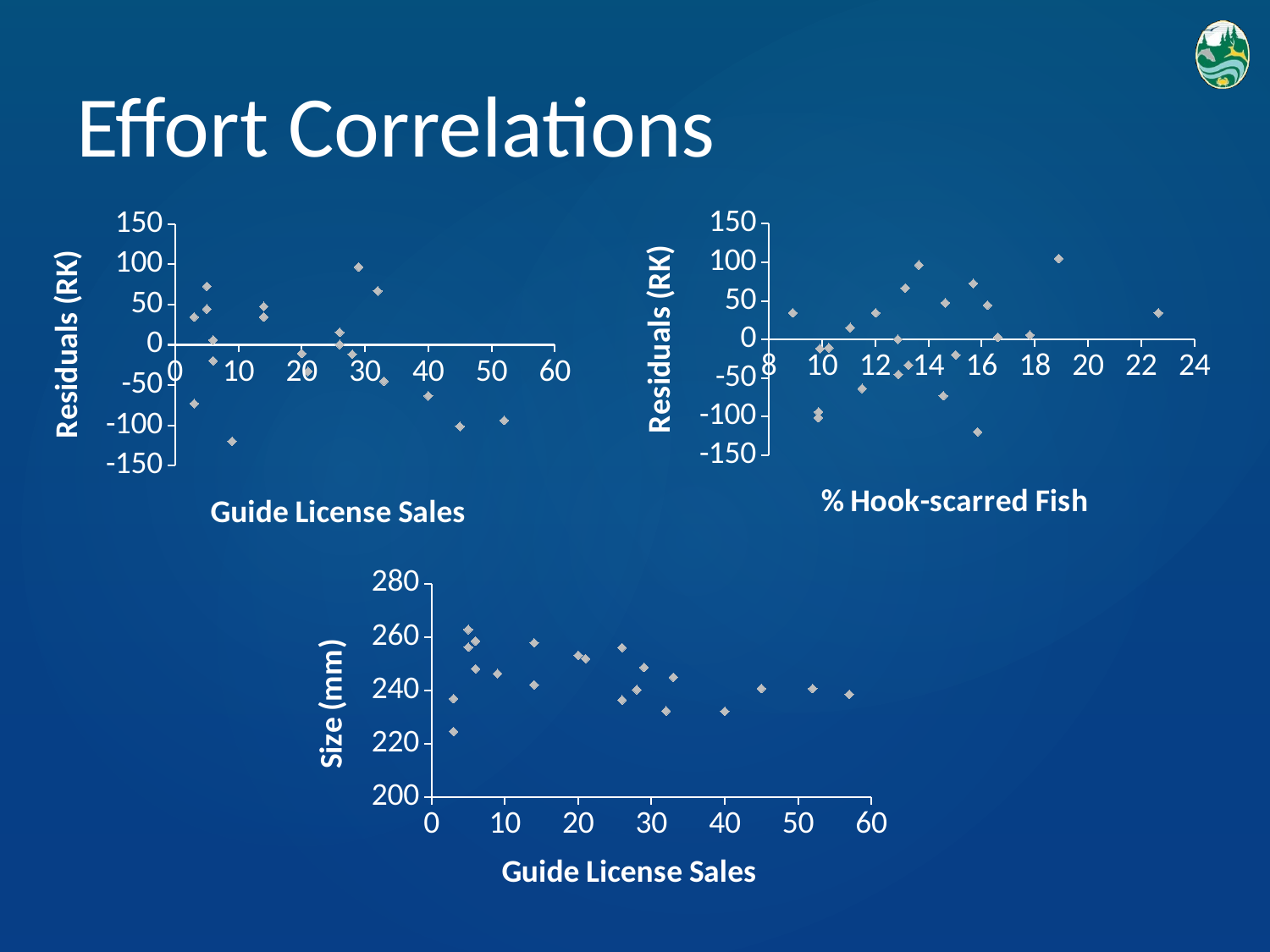
What kind of chart is the bottom chart titled with the x-axis 'Guide License Sales' and y-axis 'Size (mm)'? scatter chart How many charts are shown on the slide? 3 In the top-left chart (Residuals (RK) vs Guide License Sales), is the lowest plotted residual greater or less than -100? less What is the x-axis label of the top-right chart? % Hook-scarred Fish What is the y-axis label of the bottom chart? Size (mm) In the bottom chart (Size (mm) vs Guide License Sales), is the lowest plotted size greater or less than 200? greater In the bottom chart (Size (mm) vs Guide License Sales), is the highest plotted size greater or less than 280? less In the bottom chart (Size (mm) vs Guide License Sales), do the sizes generally rise or fall as Guide License Sales increase? fall What is the maximum value shown on the x axis of the top-right chart (% Hook-scarred Fish)? 24